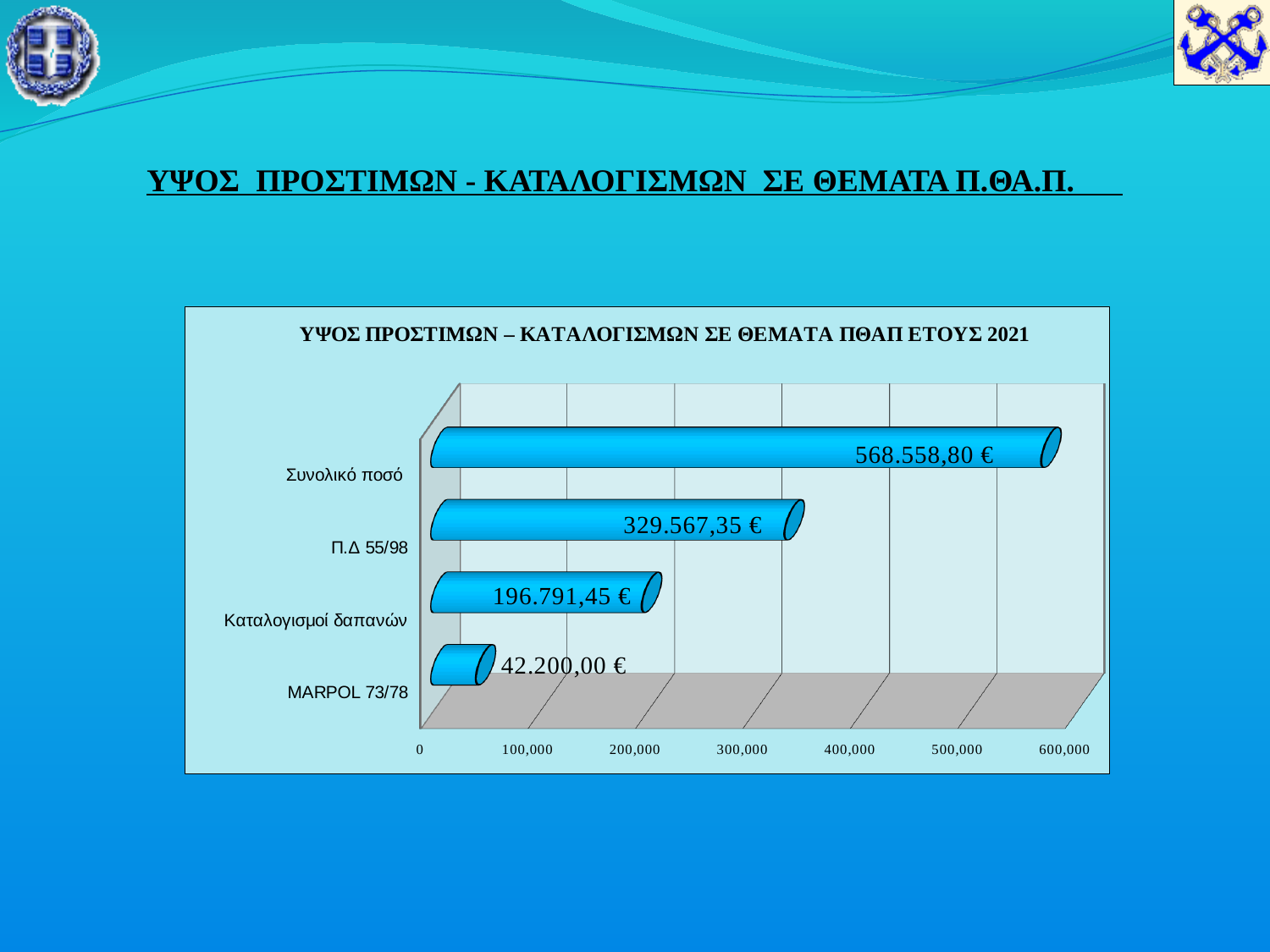
What is the value for Καταλογισμοί δαπανών? 196.791,45 € What is the difference between the values for Π.Δ 55/98 and Καταλογισμοί δαπανών? 132.775,90 € What is the value for Π.Δ 55/98? 329.567,35 € How many categories are shown in the chart? 4 Which category has the highest value? Συνολικό ποσό Which is larger, the value for Π.Δ 55/98 or the value for Καταλογισμοί δαπανών? Π.Δ 55/98 What kind of chart is shown on the slide? Bar chart Which category has the lowest value? MARPOL 73/78 What is the value for Συνολικό ποσό? 568.558,80 € What is the title of the chart? ΥΨΟΣ ΠΡΟΣΤΙΜΩΝ – ΚΑΤΑΛΟΓΙΣΜΩΝ ΣΕ ΘΕΜΑΤΑ ΠΘΑΠ ΕΤΟΥΣ 2021 What is the value for MARPOL 73/78? 42.200,00 € What is the difference between the values for Καταλογισμοί δαπανών and MARPOL 73/78? 154.591,45 €